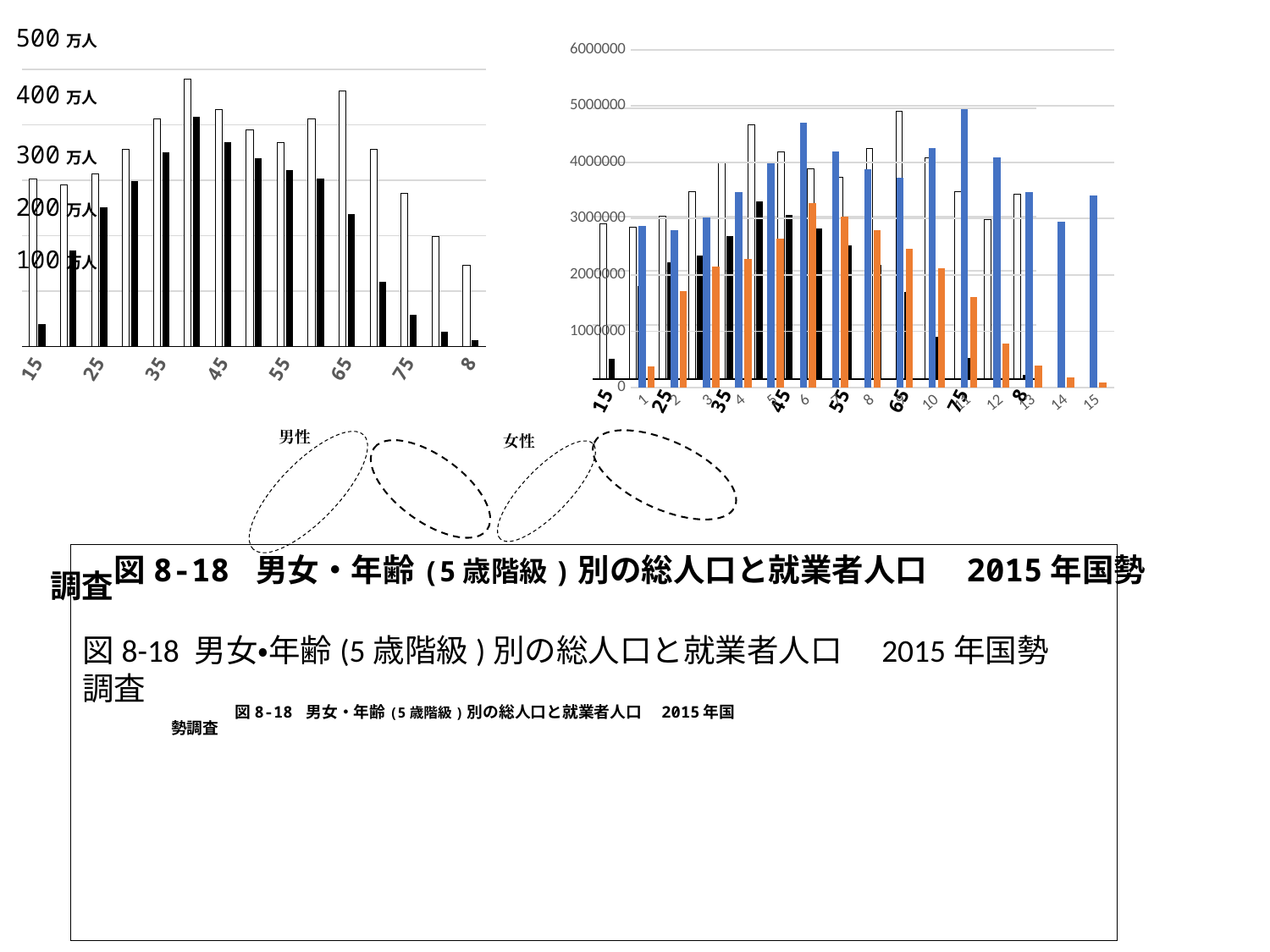
In the right chart, is the orange bar at category 15 greater or less than 1000000? less In the right chart, is the blue bar at category 11 greater or less than 4000000? greater In the left chart, is the black bar at the 15 label greater or less than 100万人? less In the right chart, what is the highest value labelled on the vertical axis? 6000000 In the left chart, what is the highest value labelled on the vertical axis? 500万人 In the right chart, which category has the tallest blue bar? 11 What kind of chart is the chart on the right of the slide? bar chart What kind of chart is the chart on the left of the slide? bar chart